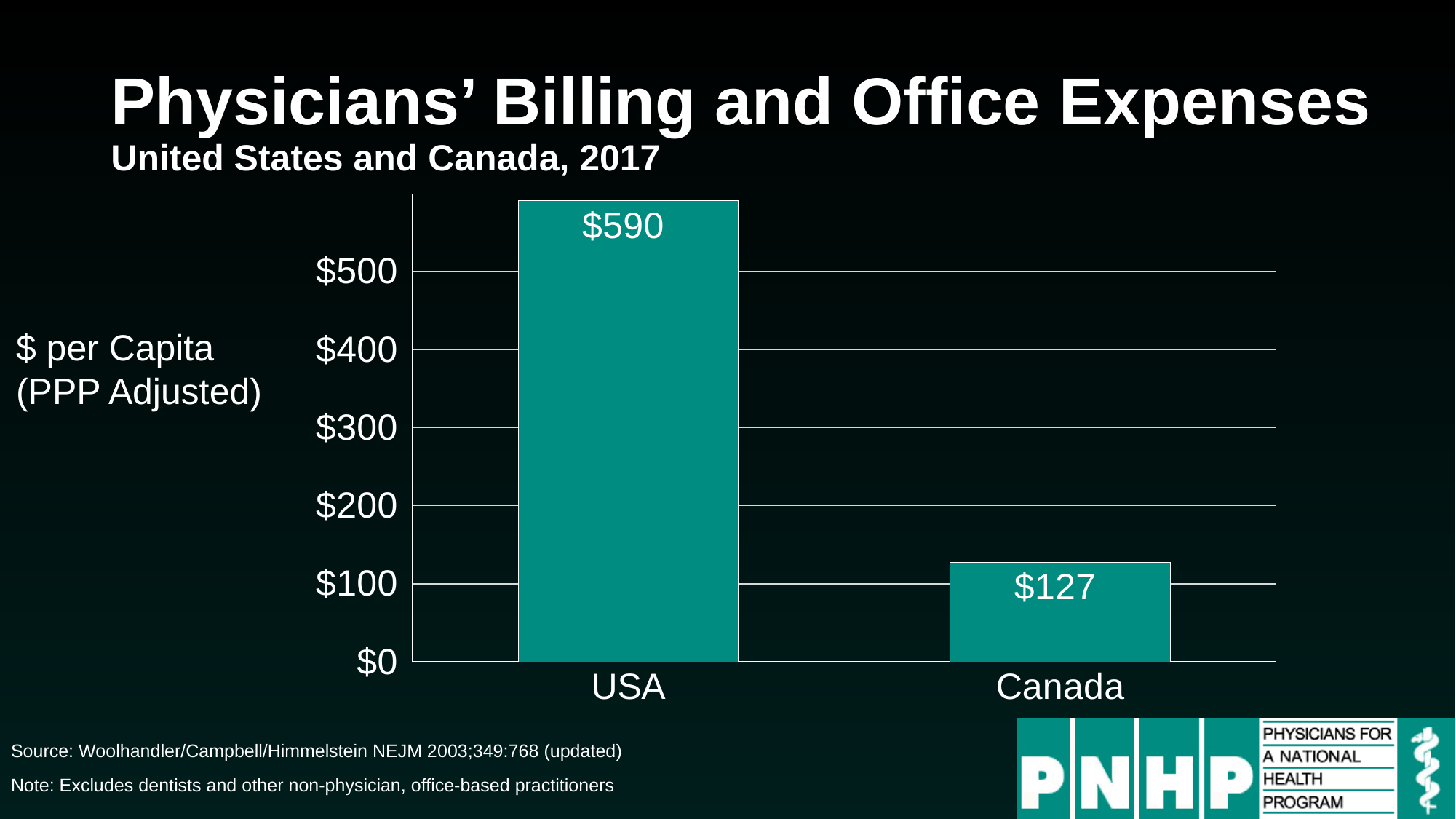
What is the difference between the USA and Canada values? $463 What is the title of the chart? Physicians' Billing and Office Expenses Which is larger, the value for USA or the value for Canada? USA How many countries are shown in the chart? 2 What is the value for USA? $590 Is the value for Canada greater or less than $200? less What kind of chart is shown on the slide? bar chart Is the value for USA greater or less than $500? greater Which country has the highest physicians' billing and office expenses per capita? USA What is the value for Canada? $127 Which country has the lowest physicians' billing and office expenses per capita? Canada What is the label on the vertical axis? $ per Capita (PPP Adjusted)